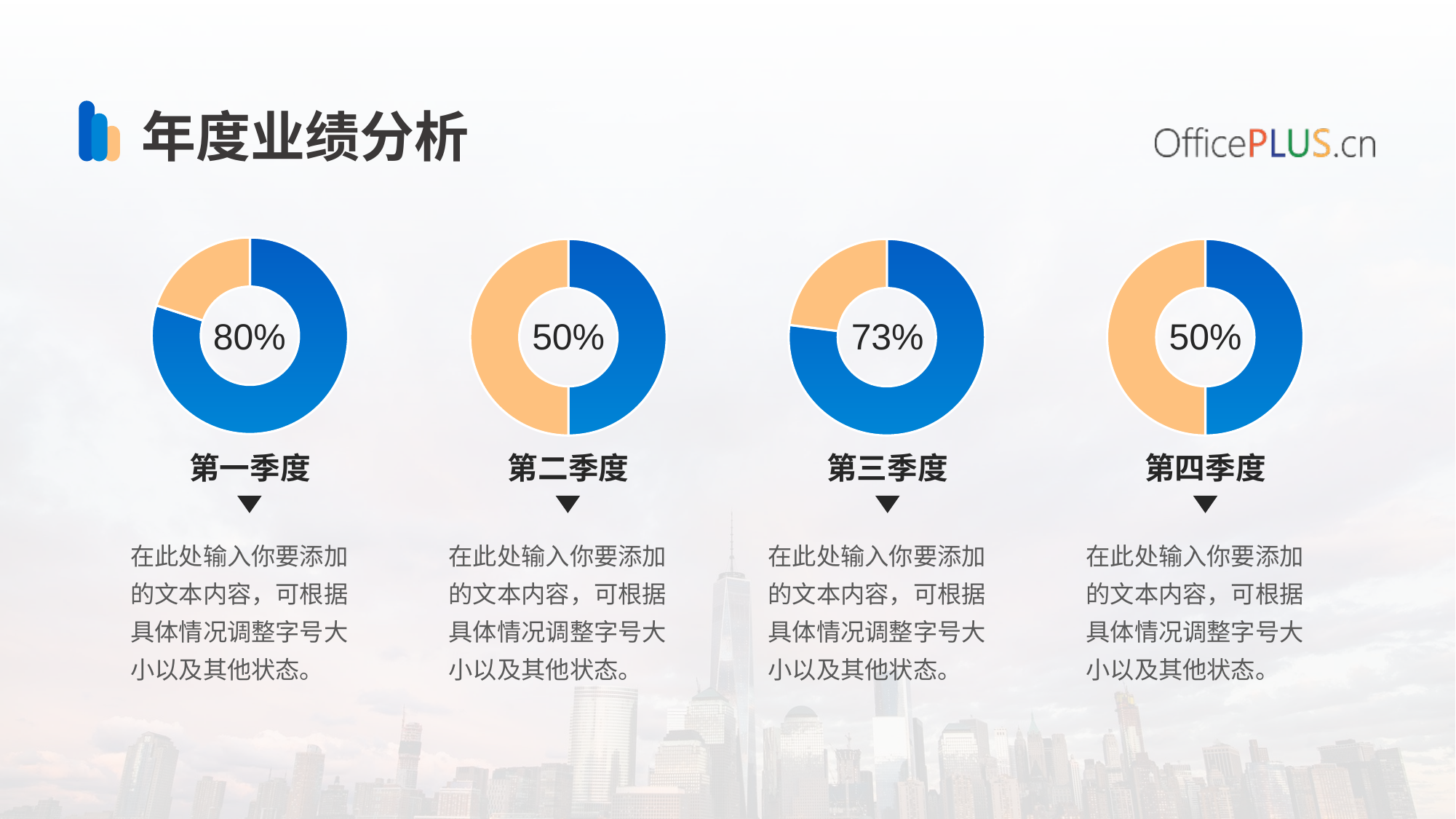
How many donut charts are on the slide? 4 What is the difference between the percentages shown for 第三季度 and 第二季度? 23% What kind of chart is used for each quarter on the slide? Donut chart What percentage is shown in the centre of the 第四季度 donut chart? 50% What is the difference between the percentages shown for 第一季度 and 第三季度? 7% What is the title of the slide containing the four donut charts? 年度业绩分析 What percentage is shown in the centre of the 第三季度 donut chart? 73% What percentage is shown in the centre of the 第一季度 donut chart? 80% Which two quarters' donut charts share the lowest percentage? 第二季度 and 第四季度 Which is larger, the percentage for 第一季度 or for 第三季度? 第一季度 Which quarter's donut chart shows the highest percentage? 第一季度 What percentage is shown in the centre of the 第二季度 donut chart? 50%